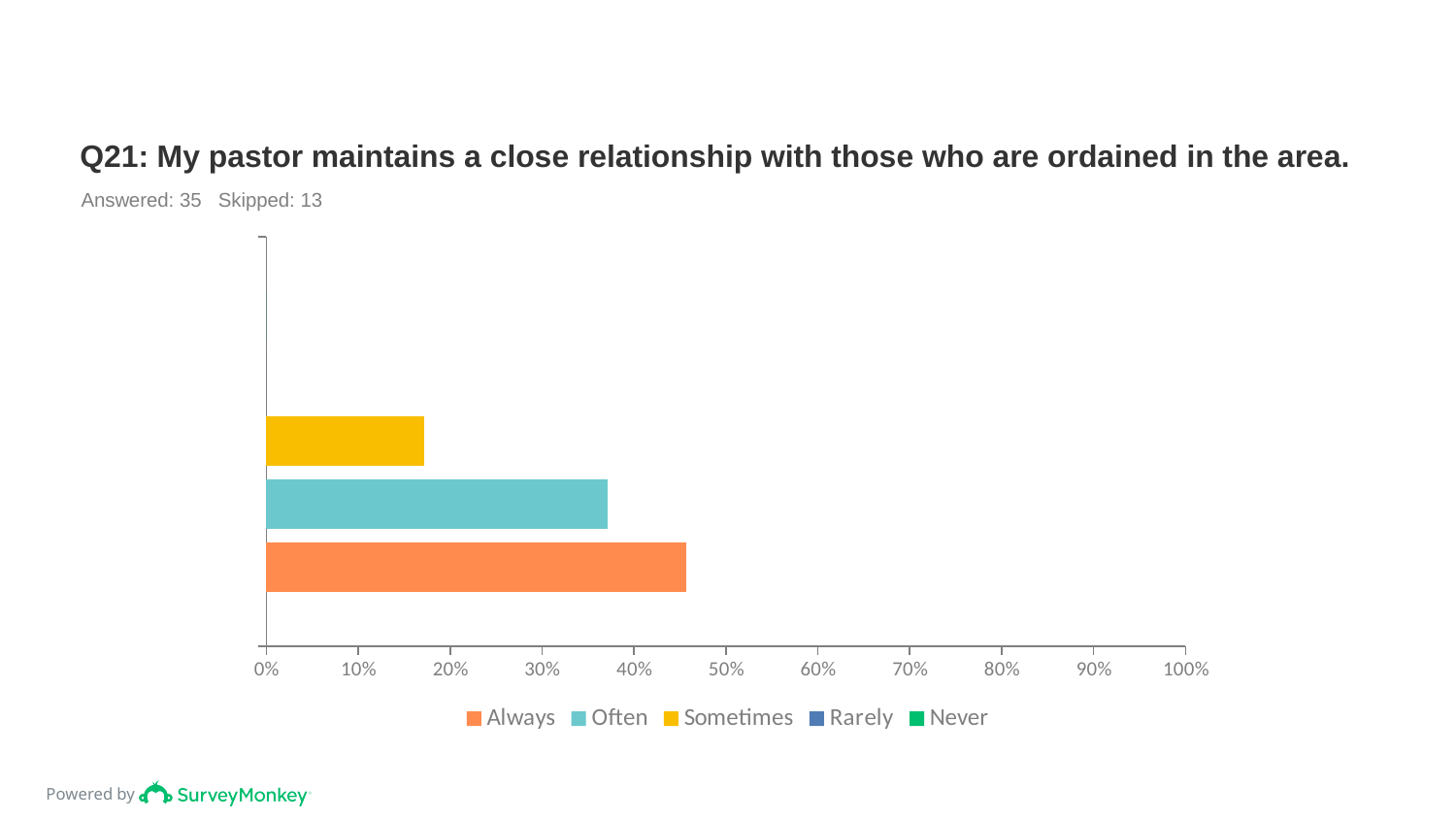
Which legend entry is shown in orange? Always How many series does the legend list? 5 Which is larger, the value for Often or the value for Sometimes? Often Is the value for Always greater or less than 40%? greater Is the value for Sometimes greater or less than 20%? less Is the value for Often greater or less than 40%? less How many respondents answered this question according to the slide? 35 How many response options have a visible bar in the chart? 3 Which is larger, the value for Always or the value for Often? Always What kind of chart is shown on the slide? bar chart Which response option has the longest bar? Always